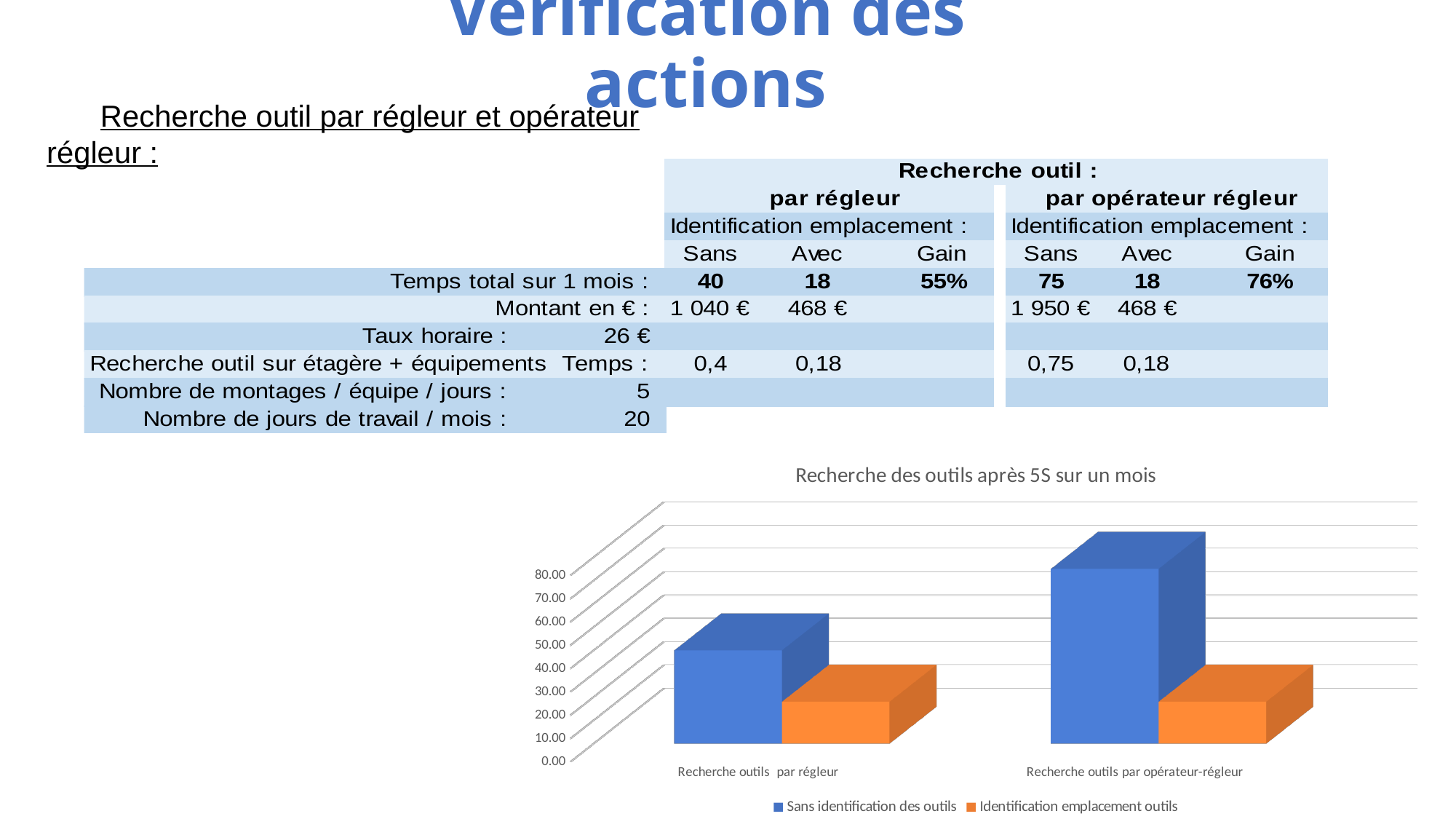
In the chart, which category has the tallest bar for "Sans identification des outils"? Recherche outils par opérateur-régleur In the chart, is the "Identification emplacement outils" value for "Recherche outils par régleur" greater or less than 30? less How many categories are shown on the x axis of the chart? 2 What kind of chart is shown under the title "Recherche des outils après 5S sur un mois"? bar chart In the chart, is the "Sans identification des outils" value for "Recherche outils par régleur" greater or less than 30? greater In the chart, is the "Sans identification des outils" bar larger for "Recherche outils par régleur" or for "Recherche outils par opérateur-régleur"? Recherche outils par opérateur-régleur How many series does the legend of the chart list? 2 In the chart, is the "Sans identification des outils" value for "Recherche outils par régleur" greater or less than 60? less What is the title of the chart at the bottom of the slide? Recherche des outils après 5S sur un mois For "Recherche outils par opérateur-régleur", which series has the smaller bar in the chart? Identification emplacement outils Which series is shown in orange in the chart? Identification emplacement outils